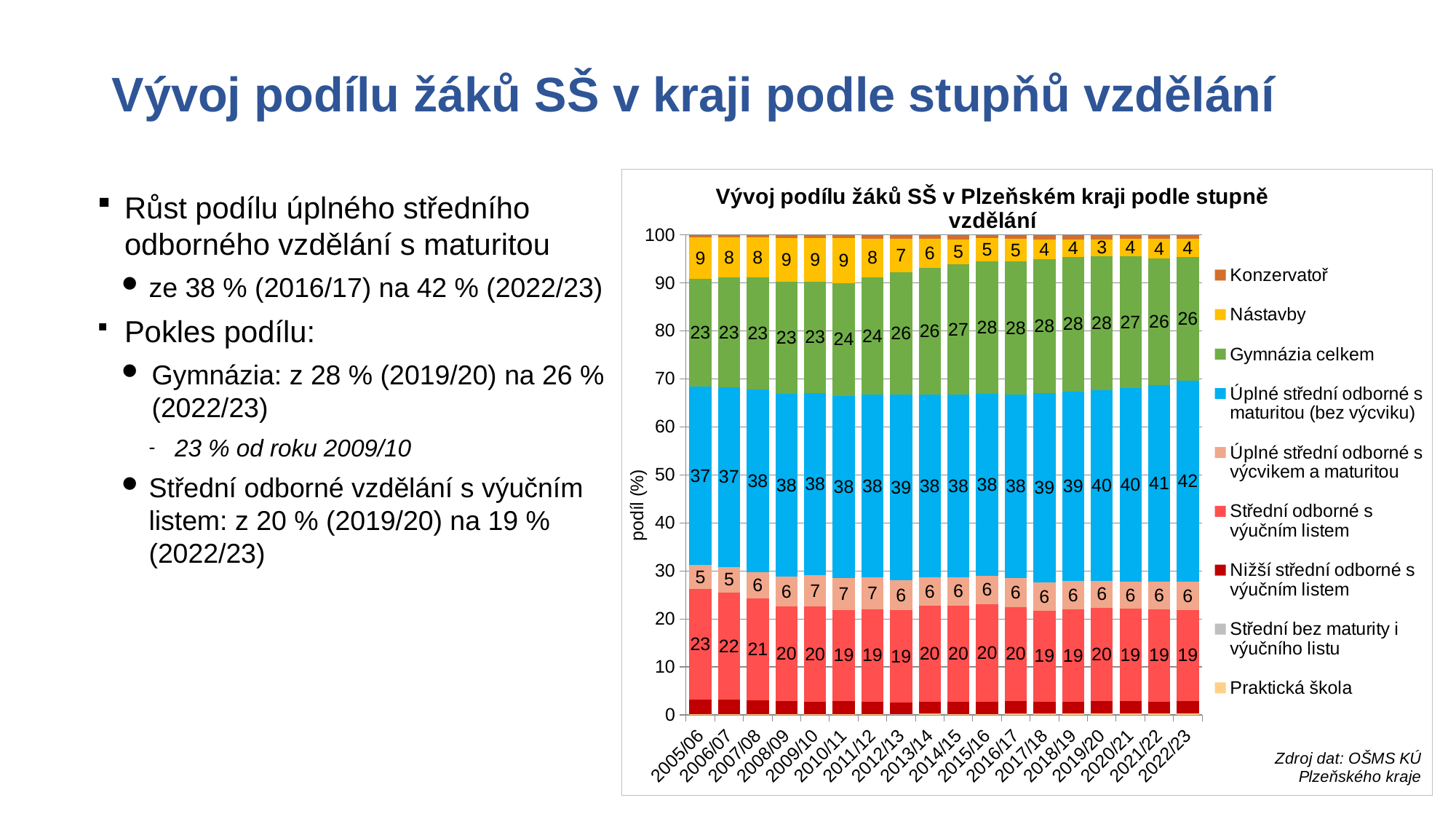
How many series does the chart legend list? 9 What is the value for 'Gymnázia celkem' in 2005/06? 23 Which year has the larger value for 'Nástavby': 2005/06 or 2022/23? 2005/06 What is the value for 'Úplné střední odborné s maturitou (bez výcviku)' in 2022/23? 42 What is the value for 'Střední odborné s výučním listem' in 2022/23? 19 What type of chart is shown on the slide? Stacked bar chart In which school year is the value for 'Úplné střední odborné s maturitou (bez výcviku)' highest? 2022/23 Does the value for 'Nástavby' generally rise or fall from 2005/06 to 2022/23? Fall How many school years (categories) are shown on the x axis of the chart? 18 What is the difference between the 'Úplné střední odborné s maturitou (bez výcviku)' values in 2022/23 and 2005/06? 5 In which school year is the value for 'Nástavby' lowest? 2019/20 What is the value for 'Nástavby' in 2005/06? 9